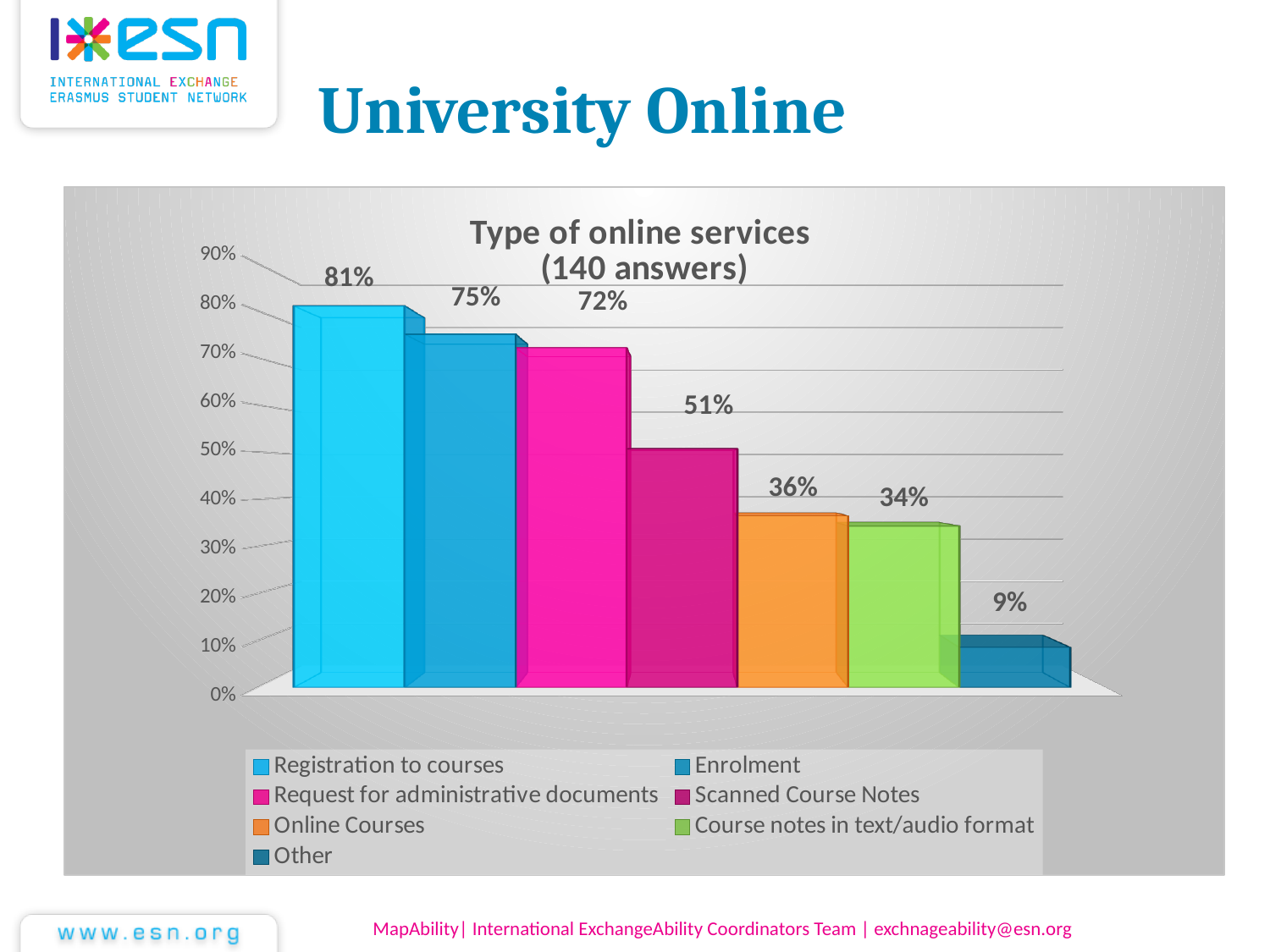
Which category has the lowest value? Other What kind of chart is shown? bar chart Which category has the highest value? Registration to courses Do the values rise or fall from left to right across the bars? fall Is the value for Online Courses greater or less than 40%? less What is the value for Registration to courses? 81% What is the value for Scanned Course Notes? 51% How many answers does the chart title say the data is based on? 140 What is the value for Course notes in text/audio format? 34% How many categories are shown in the chart? 7 What is the difference between Enrolment and Online Courses? 39% Which is larger, Request for administrative documents or Scanned Course Notes? Request for administrative documents